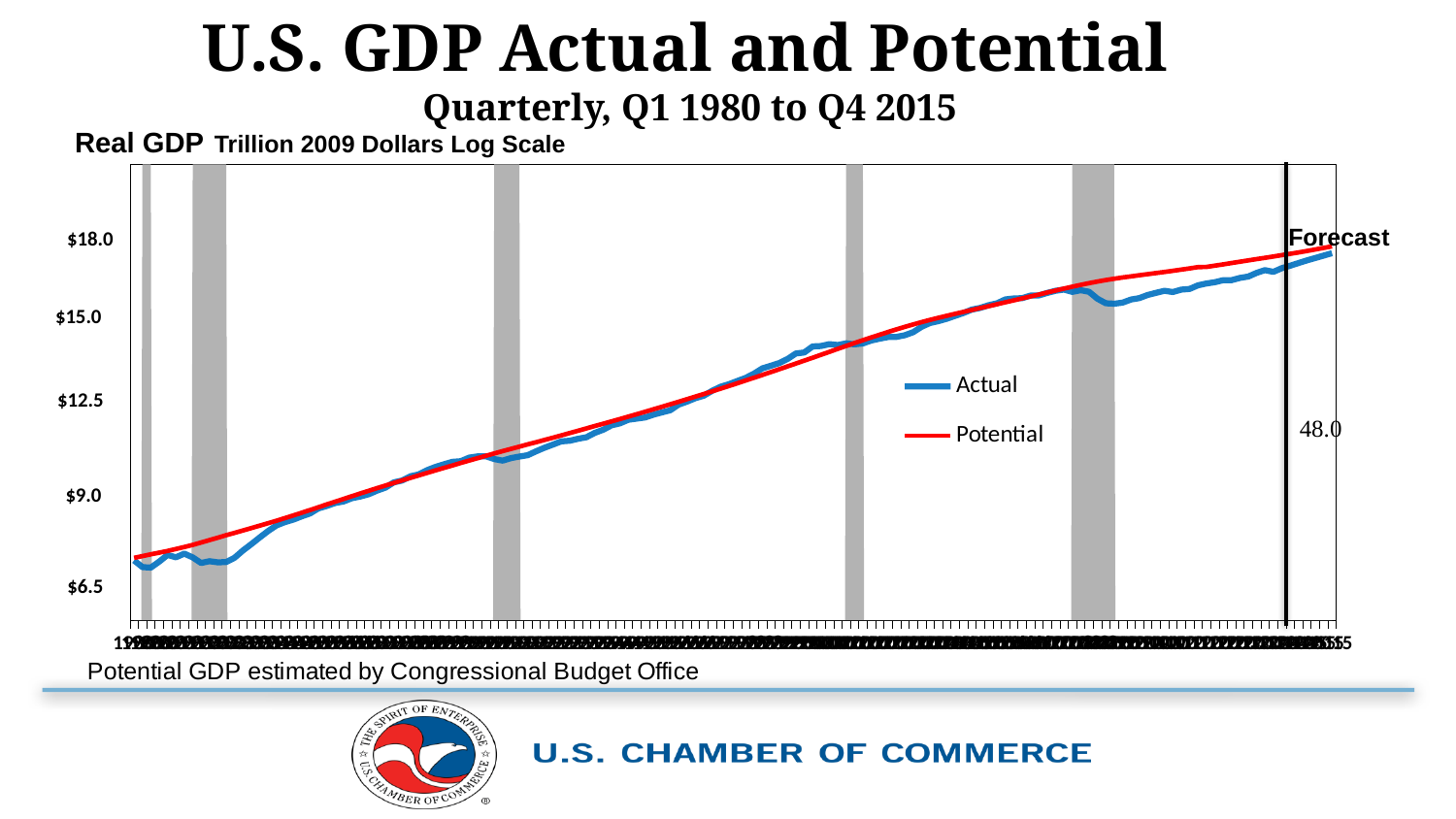
At the start of the chart, which series is higher, Actual or Potential? Potential Which colour is used for the Potential series? red How many series does the legend list? 2 Is the value of the Actual series at the end of the chart (Q4 2015) greater or less than $15.0? greater What kind of chart is shown on the slide? line chart Is the value of the Actual series at the start of the chart (Q1 1980) greater or less than $9.0? less At the right end of the chart, which series is higher, Actual or Potential? Potential What are the two series named in the legend? Actual and Potential Do the Actual GDP values generally rise or fall from left to right along the x axis? rise Is the value of the Potential series at the end of the chart greater or less than $18.0? less